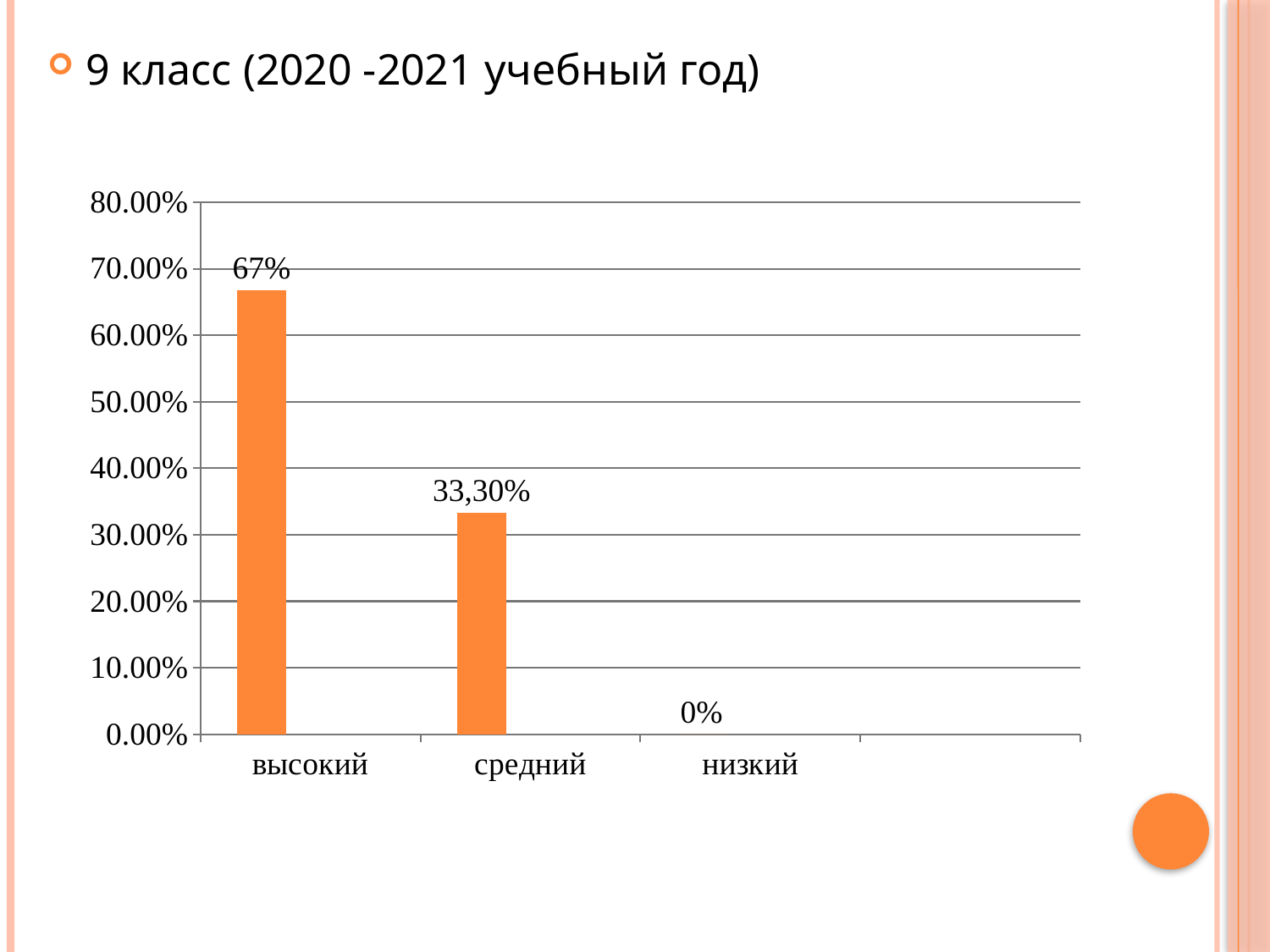
What is the value for средний? 33,30% How many categories are shown on the x axis? 3 What is the value for низкий? 0% Which is larger, the value for высокий or the value for средний? высокий Is the value for высокий greater or less than 60.00%? greater Which category has the lowest value? низкий What is the value for высокий? 67% What kind of chart is shown on the slide? bar chart Is the value for средний greater or less than 40.00%? less What is the highest value shown on the vertical axis? 80.00% Which category has the highest value? высокий Do the values rise or fall from left to right along the x axis? fall